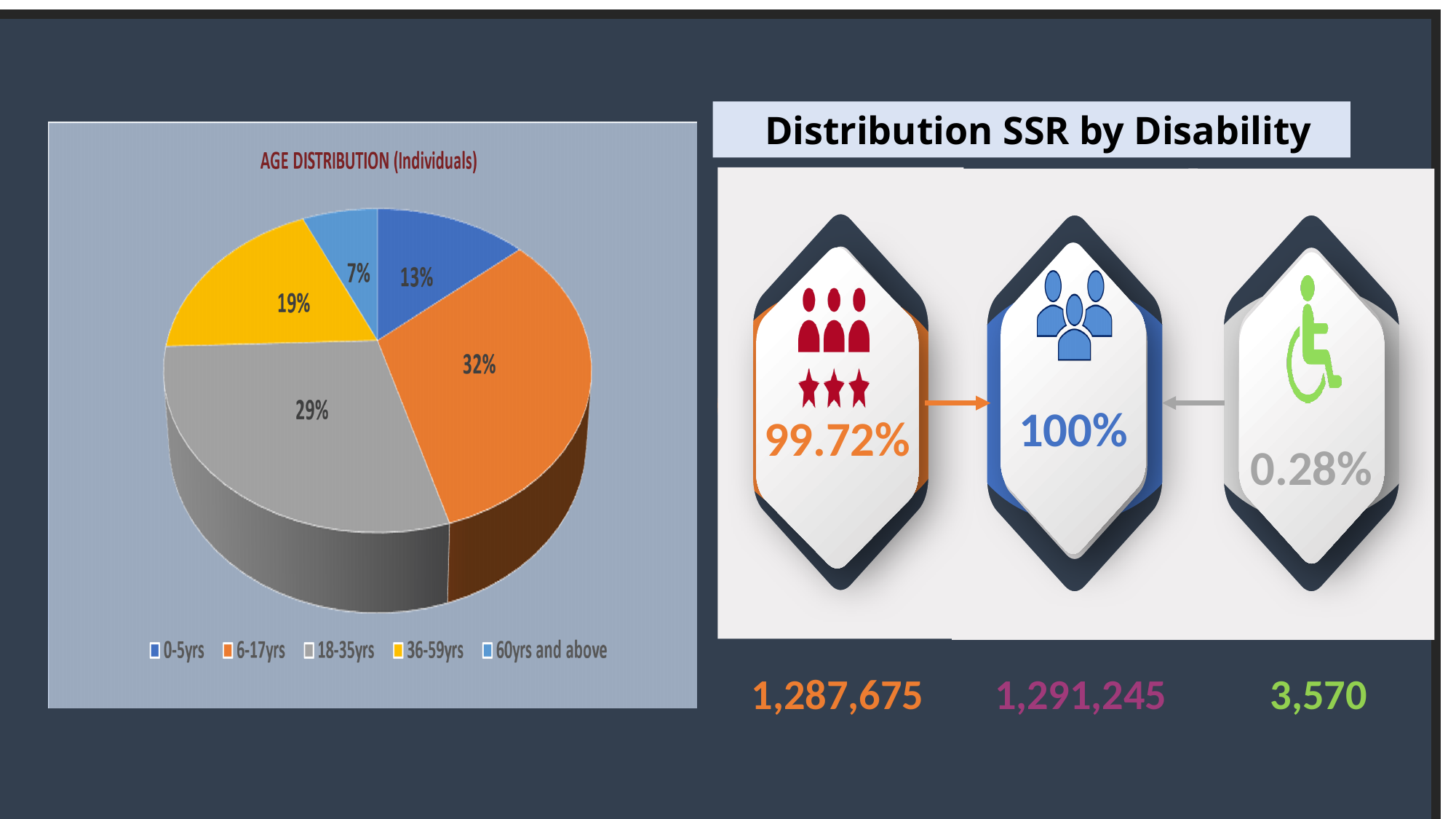
In the AGE DISTRIBUTION (Individuals) pie chart, what share is the 0-5yrs slice? 13% In the AGE DISTRIBUTION (Individuals) pie chart, what share is the 60yrs and above slice? 7% In the AGE DISTRIBUTION (Individuals) pie chart, what share is the 6-17yrs slice? 32% In the AGE DISTRIBUTION (Individuals) pie chart, what colour is the 36-59yrs slice? Yellow In the AGE DISTRIBUTION (Individuals) pie chart, what share is the 36-59yrs slice? 19% How many age groups are shown in the AGE DISTRIBUTION (Individuals) pie chart? 5 What type of chart is the AGE DISTRIBUTION (Individuals) chart? Pie chart Which age group has the largest slice in the AGE DISTRIBUTION (Individuals) pie chart? 6-17yrs In the AGE DISTRIBUTION (Individuals) pie chart, which slice is larger: 0-5yrs or 36-59yrs? 36-59yrs In the AGE DISTRIBUTION (Individuals) pie chart, what is the difference in percentage points between the 6-17yrs and 36-59yrs slices? 13 In the AGE DISTRIBUTION (Individuals) pie chart, what share is the 18-35yrs slice? 29% Which age group has the smallest slice in the AGE DISTRIBUTION (Individuals) pie chart? 60yrs and above